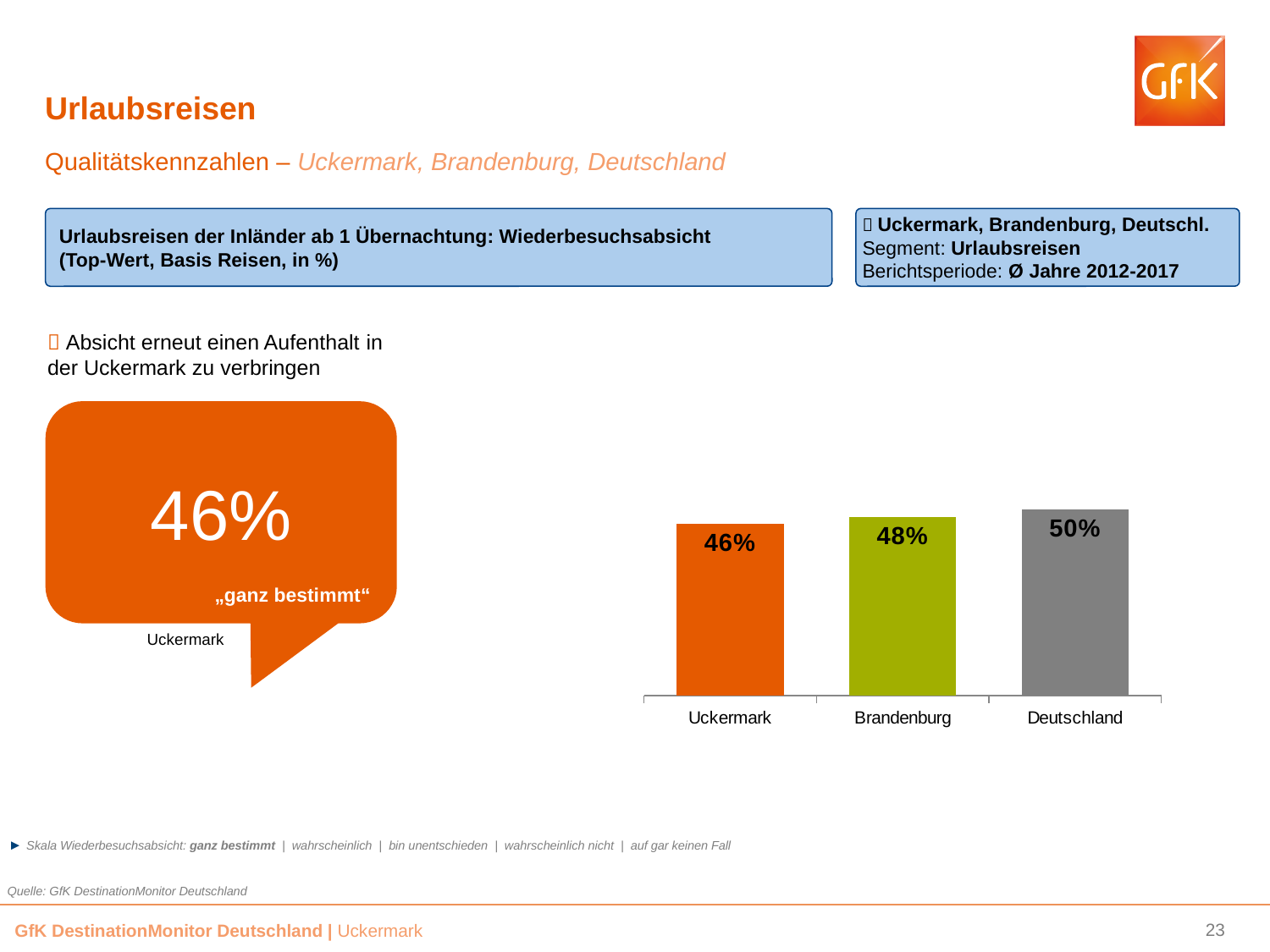
Which category has the lowest value in the bar chart? Uckermark Do the values rise or fall from Uckermark to Deutschland along the x axis? Rise What is the difference between the values for Brandenburg and Uckermark? 2 percentage points Which category has the highest value in the bar chart? Deutschland Which is larger, the value for Brandenburg or the value for Deutschland? Deutschland What is the value for Uckermark in the bar chart? 46% What is the value for Brandenburg in the bar chart? 48% What kind of chart is shown on the slide? Bar chart What colour is the bar for Uckermark? Orange How many categories are shown in the bar chart? 3 What is the difference between the values for Deutschland and Uckermark? 4 percentage points What is the value for Deutschland in the bar chart? 50%